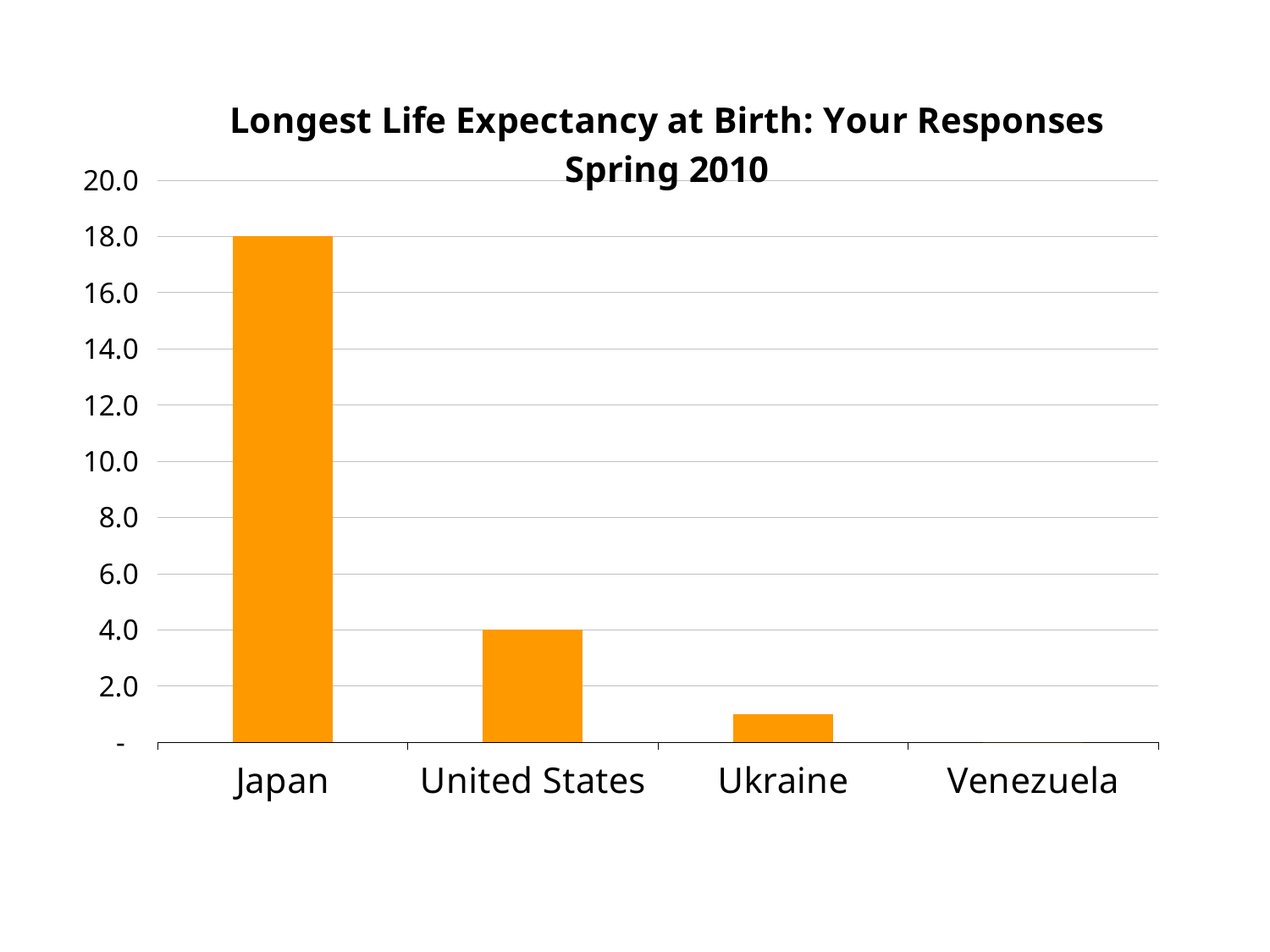
What is the difference between the values for Japan and United States? 14.0 What is the value for United States? 4.0 What is the value for Japan? 18.0 What kind of chart is shown on the slide? bar chart Is the value for Ukraine greater or less than 2.0? less Which country has the highest value? Japan Which has the larger value, United States or Ukraine? United States Do the values rise or fall from left to right along the x axis? fall What colour are the bars in the chart? orange Which country has the lowest value? Venezuela What is the title of the chart? Longest Life Expectancy at Birth: Your Responses Spring 2010 How many countries are shown on the x axis? 4